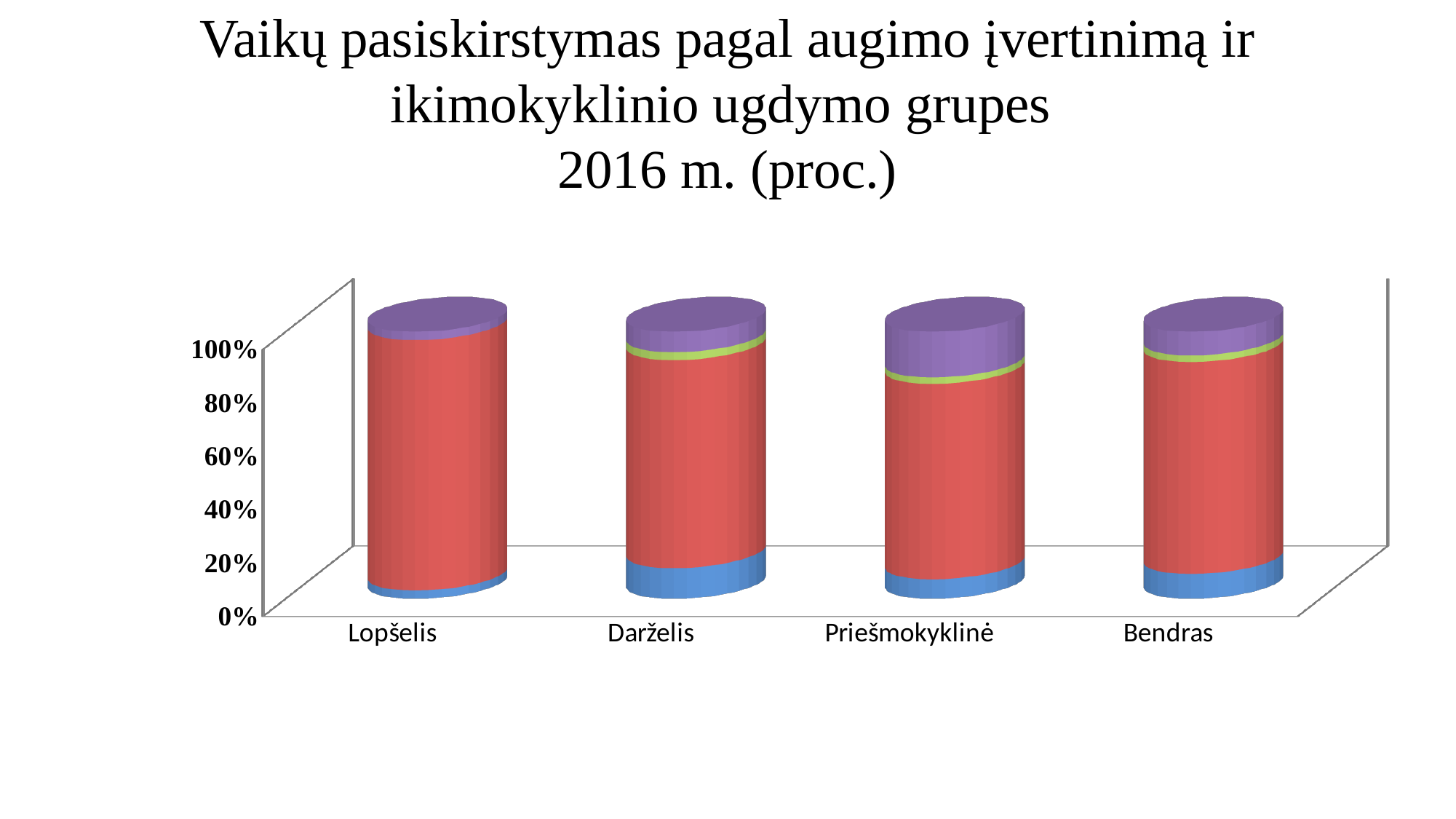
Is the blue (bottom) segment for Lopšelis greater or less than 20%? less Is the purple (top) segment for Priešmokyklinė larger or smaller than the purple segment for Lopšelis? larger Which category has the smallest purple (top) segment? Lopšelis What is the title of the chart on the slide? Vaikų pasiskirstymas pagal augimo įvertinimą ir ikimokyklinio ugdymo grupes 2016 m. (proc.) Which category has the smallest blue (bottom) segment? Lopšelis Is the red segment for Lopšelis greater or less than 80%? greater Is the blue (bottom) segment for Darželis larger or smaller than the blue segment for Lopšelis? larger Which category has the largest purple (top) segment? Priešmokyklinė What is the label of the first category on the x axis? Lopšelis What kind of chart is shown on the slide? bar chart How many categories are shown on the x axis of the chart? 4 What is the highest value shown on the vertical axis? 100%